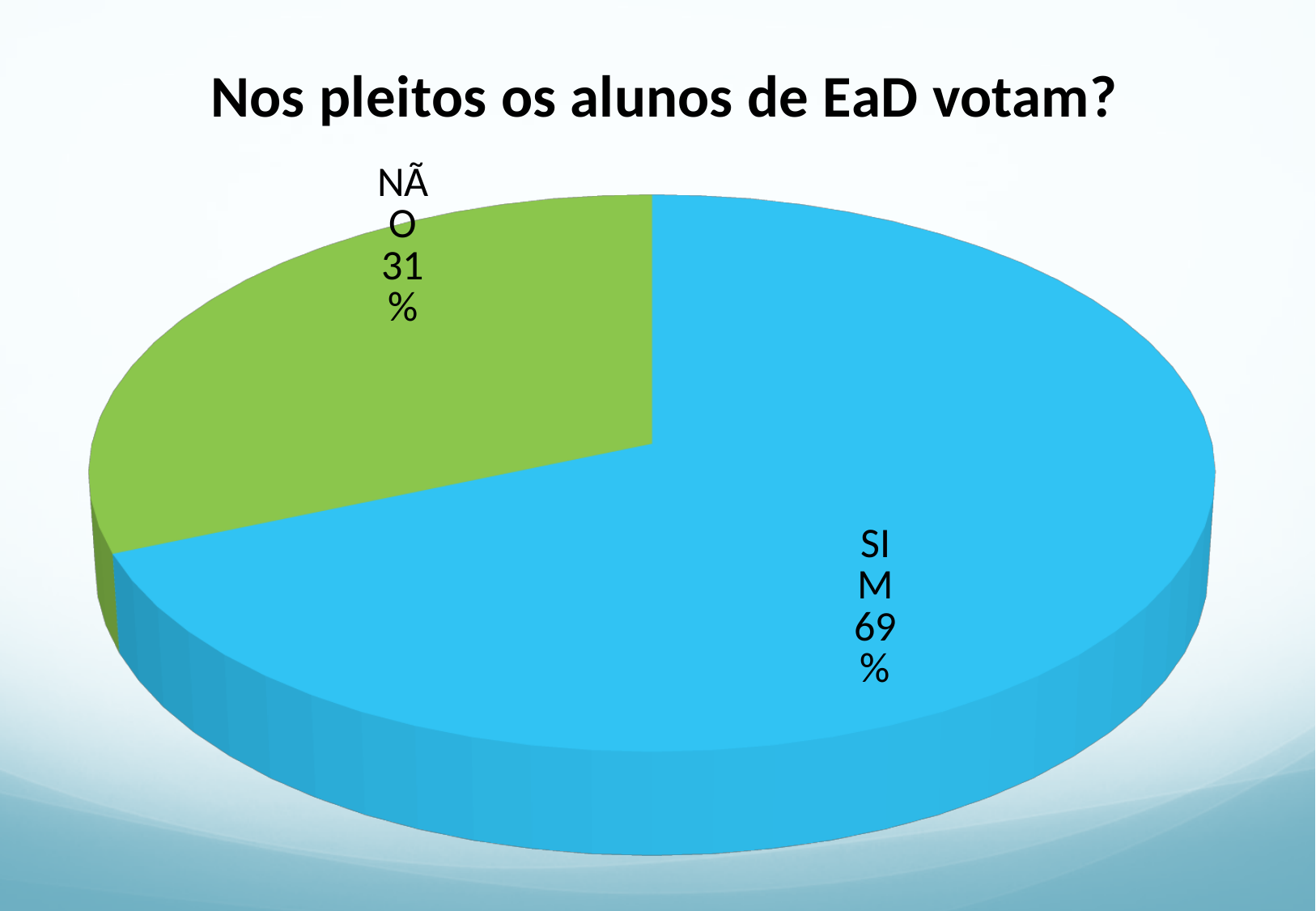
What percentage of the pie is labelled SIM? 69% Which slice is the largest? SIM What percentage of the pie is labelled NÃO? 31% What colour is the SIM slice? Blue What is the difference in percentage points between the SIM and NÃO slices? 38 Which slice is the smallest? NÃO How many slices does the pie chart have? 2 What kind of chart is shown on the slide? Pie chart What share of the pie does the NÃO slice represent? 31% What is the title of the chart? Nos pleitos os alunos de EaD votam? Which is larger, the SIM slice or the NÃO slice? SIM